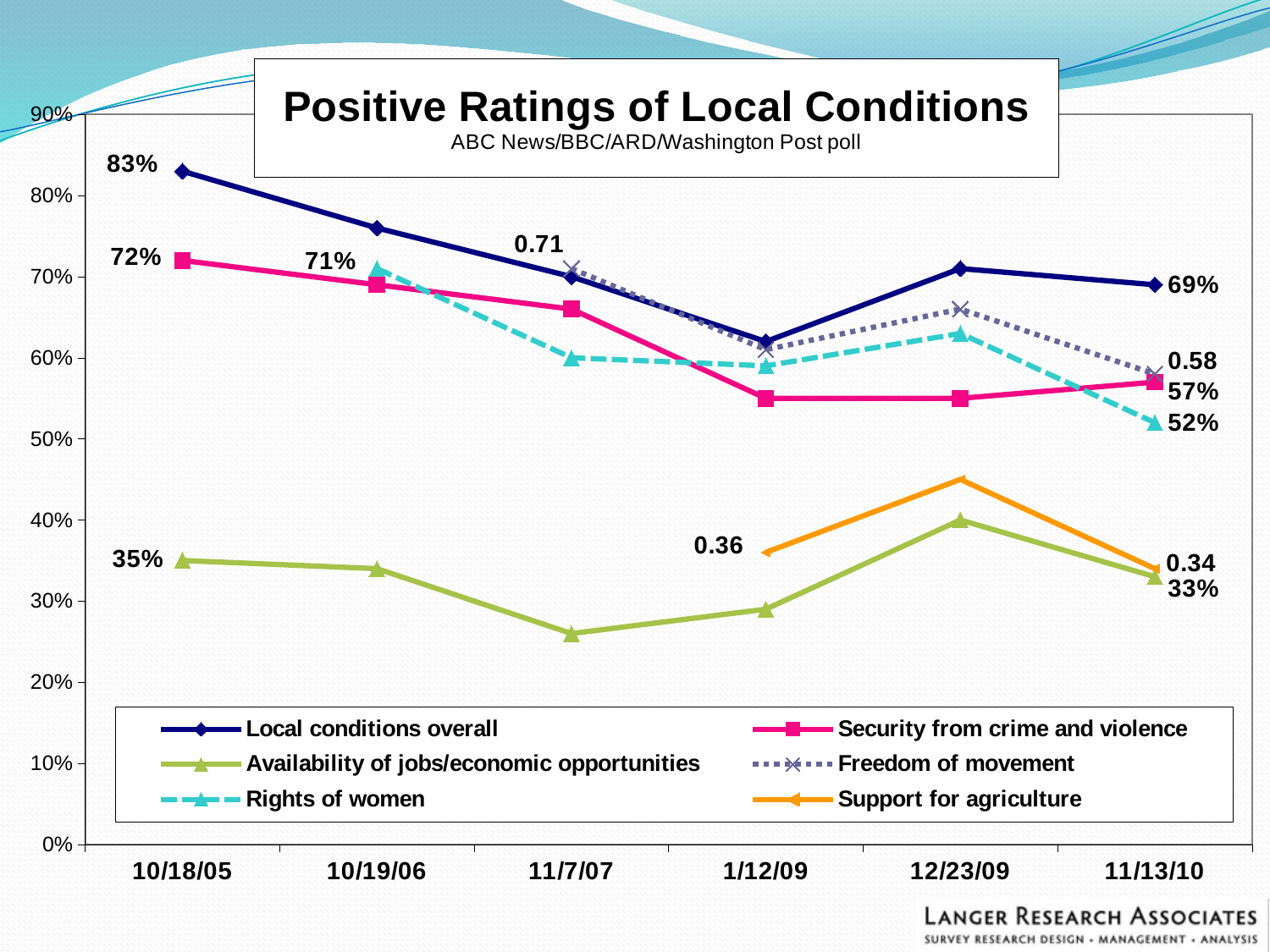
What is the value for Local conditions overall on 11/13/10? 69% What is the value for Rights of women on 11/13/10? 52% What is the value for Freedom of movement on 11/7/07? 0.71 On 11/13/10, which is larger: Security from crime and violence or Rights of women? Security from crime and violence What is the value for Support for agriculture on 1/12/09? 0.36 What is the value for Security from crime and violence on 10/18/05? 72% What kind of chart is shown on the slide? Line chart By how many percentage points did Local conditions overall fall from 10/18/05 to 11/13/10? 14 percentage points Is the value for Availability of jobs/economic opportunities on 11/7/07 greater or less than 30%? less How many series does the legend list? 6 What is the value for Local conditions overall on 10/18/05? 83% How many dates are shown on the x axis? 6